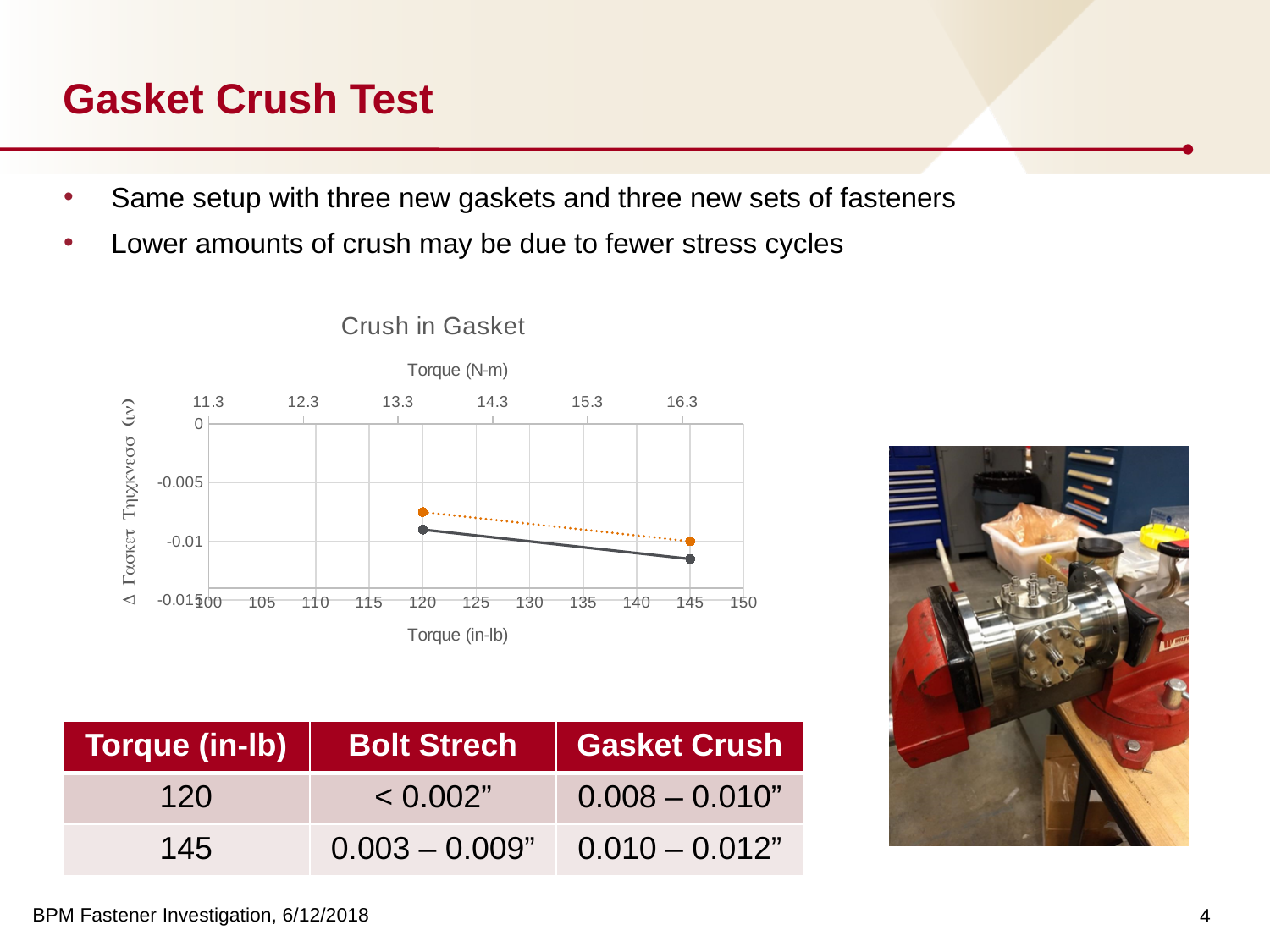
What type of chart is shown on the slide? line chart Do the plotted values rise or fall as torque increases from 120 to 145 in-lb? fall What is the highest torque value shown on the bottom x axis of the chart? 150 Is the value of the dotted orange line at 120 in-lb greater or less than -0.01? greater What is the lowest value shown on the y axis of the chart? -0.015 What is the title of the chart? Crush in Gasket At 120 in-lb, which line has the higher (less negative) value, the dotted orange line or the solid dark line? the dotted orange line Is the value of the solid dark line at 120 in-lb greater or less than -0.005? less How many data points does each line in the chart have? 2 Is the value of the solid dark line at 145 in-lb greater or less than -0.01? less What is the label of the bottom x axis of the chart? Torque (in-lb) How many lines (series) are plotted in the chart? 2